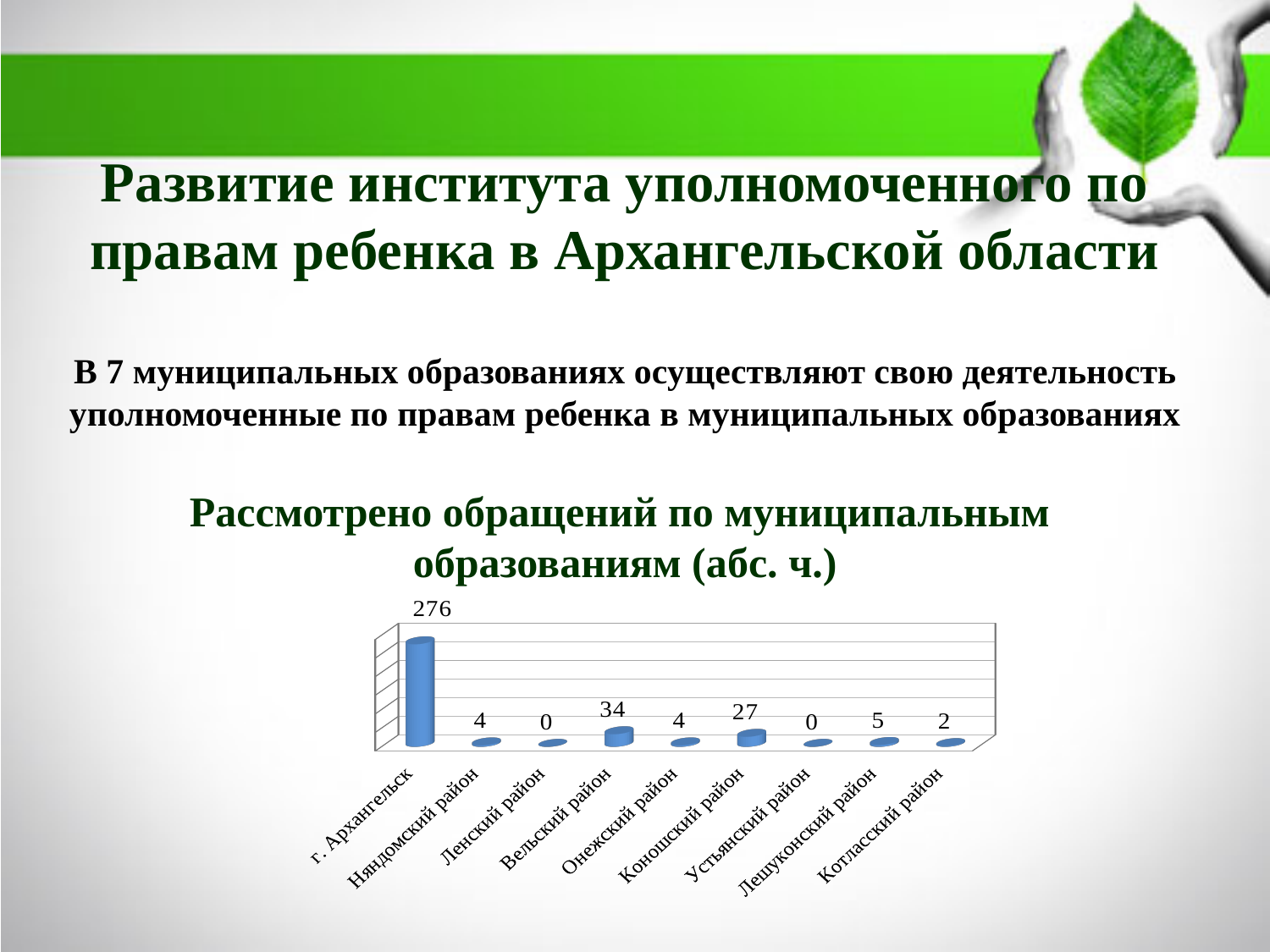
What is the value for Котласский район? 2 What kind of chart is shown on the slide? bar chart Which category has the highest value? г. Архангельск What is the difference between the values for Вельский район and Коношский район? 7 Which is larger, the value for Коношский район or the value for Лешуконский район? Коношский район What is the difference between the values for г. Архангельск and Вельский район? 242 What is the value for Коношский район? 27 What is the title of the chart? Рассмотрено обращений по муниципальным образованиям (абс. ч.) What is the value for Вельский район? 34 How many categories are shown on the x axis? 9 What is the value for Лешуконский район? 5 What is the value for г. Архангельск? 276